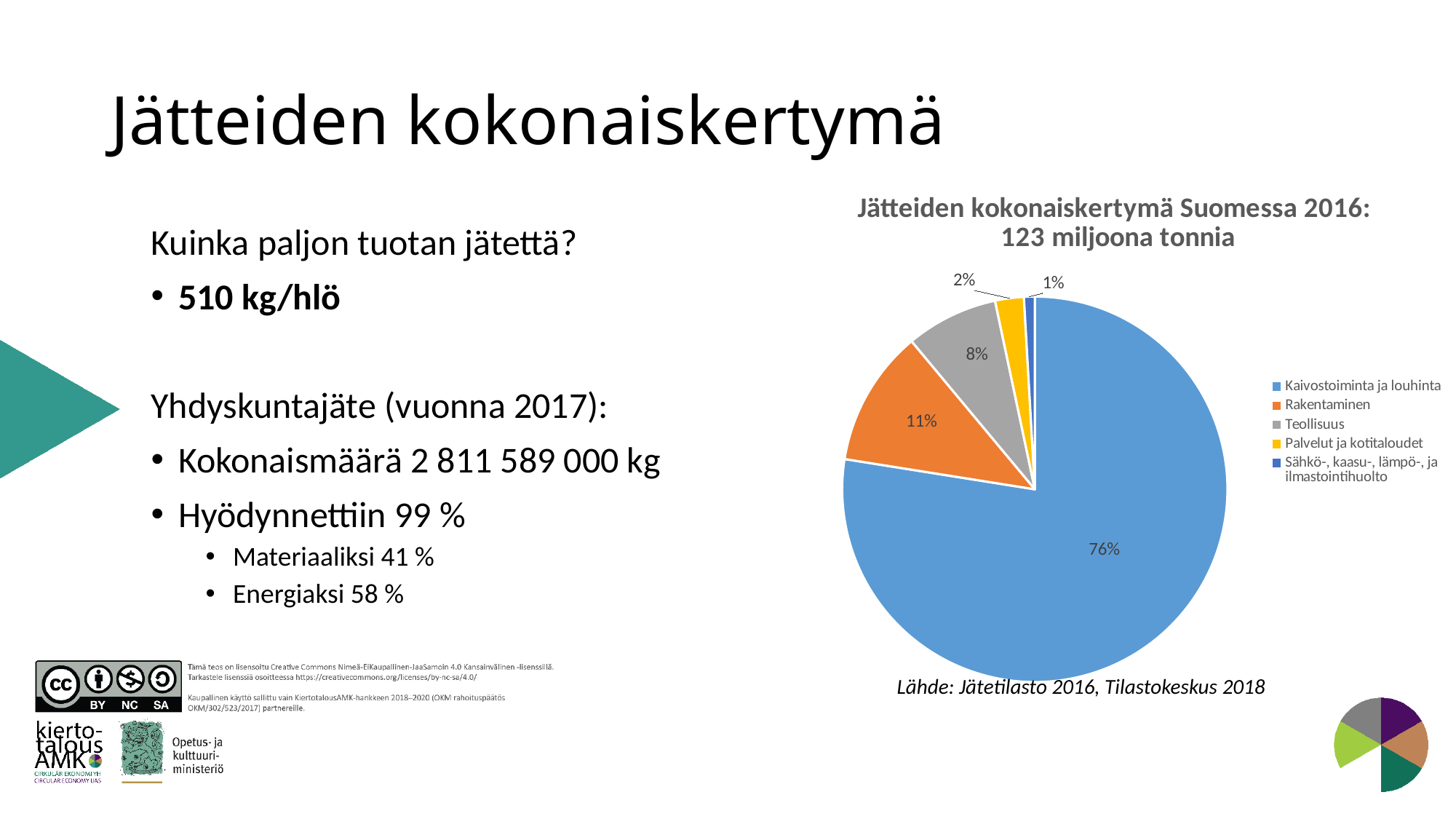
How many categories does the pie chart legend list? 5 Which is larger, the share for Teollisuus or the share for Palvelut ja kotitaloudet? Teollisuus What is the difference in percentage points between Rakentaminen and Teollisuus? 3 What share of the pie does Teollisuus have? 8% Which category has the smallest slice of the pie? Sähkö-, kaasu-, lämpö-, ja ilmastointihuolto What share of the pie does Kaivostoiminta ja louhinta have? 76% Which category has the largest slice of the pie? Kaivostoiminta ja louhinta What kind of chart is shown on the slide? Pie chart What is the title of the pie chart? Jätteiden kokonaiskertymä Suomessa 2016: 123 miljoona tonnia What share of the pie does Rakentaminen have? 11%